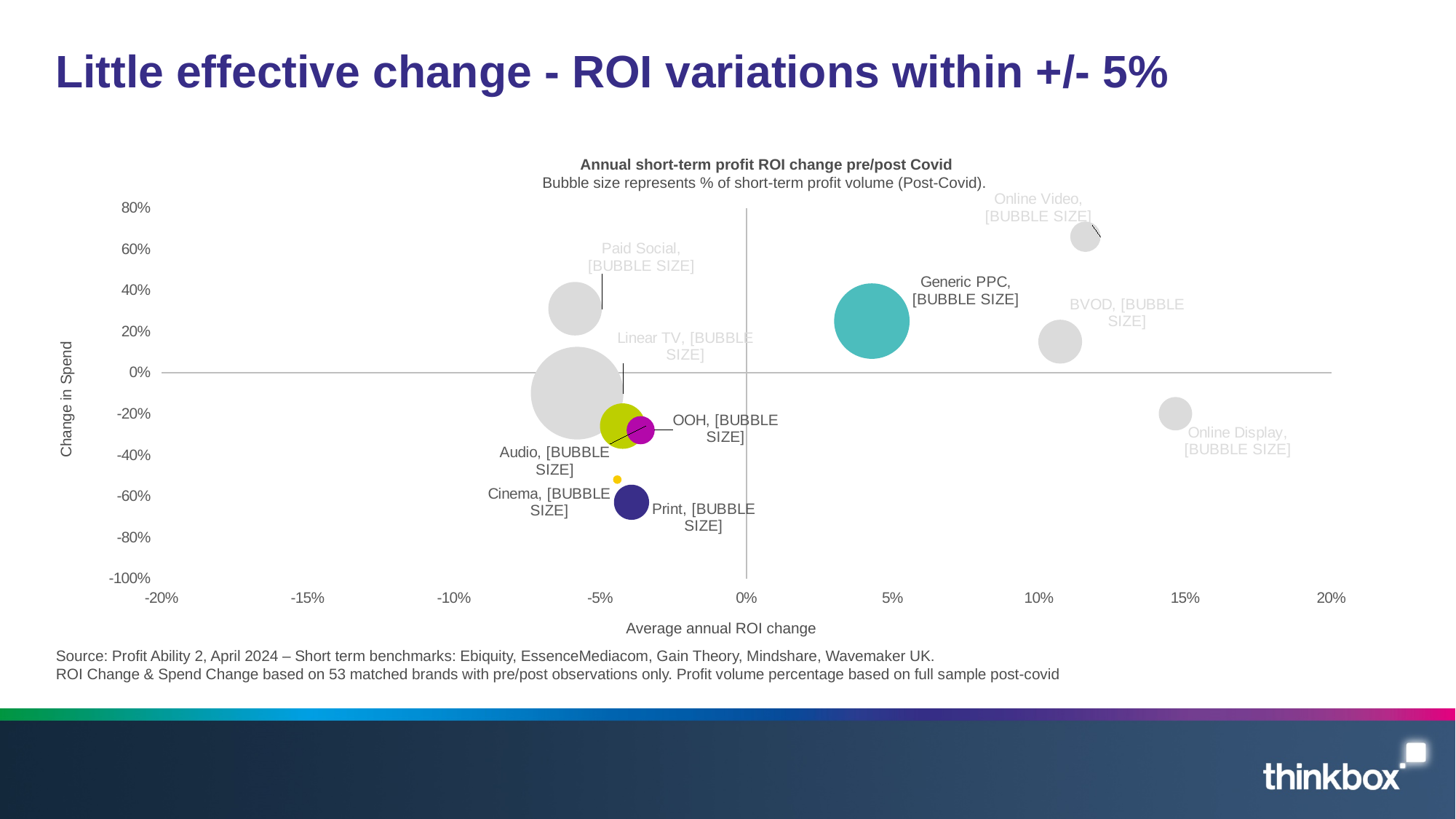
Which channel has the highest change in spend? Online Video Which channel has the highest average annual ROI change? Online Display What is the title of the chart? Annual short-term profit ROI change pre/post Covid Is the average annual ROI change for Linear TV greater or less than 0%? less Is the change in spend for Online Video greater or less than 40%? greater How many media channels (bubbles) are plotted on the chart? 10 What does the vertical axis of the chart represent? Change in Spend Is the average annual ROI change for Generic PPC greater or less than 0%? greater Which channel has a higher change in spend, Paid Social or Cinema? Paid Social What kind of chart is shown on the slide? Bubble chart Which channel has the lowest change in spend? Print